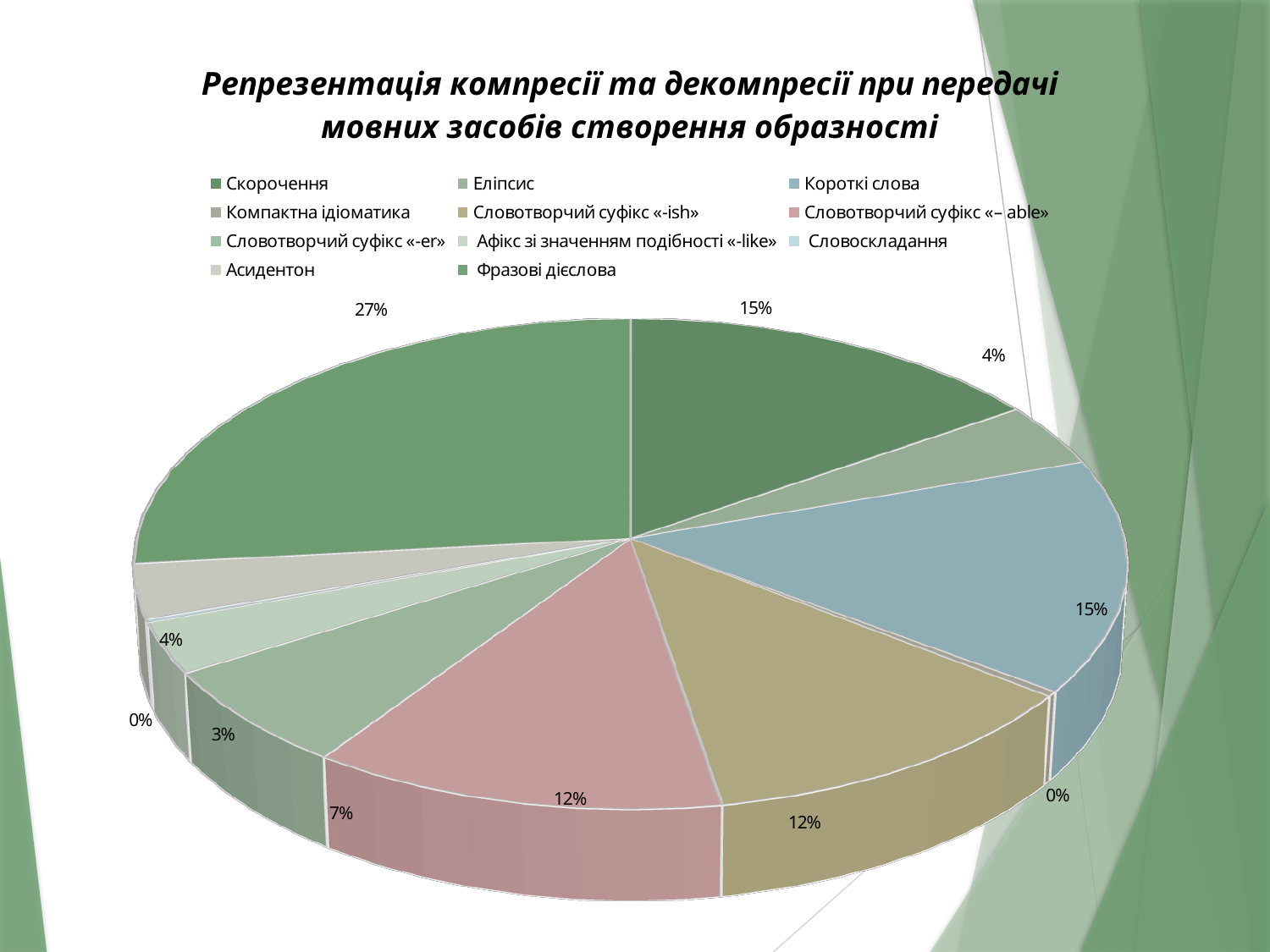
How many slices are labelled 0%? 2 What kind of chart is shown on the slide? pie chart Which is larger, the share for Скорочення or the share for Еліпсис? Скорочення Which category has the largest share of the pie? Фразові дієслова How many entries does the legend list? 11 What share of the pie does Словотворчий суфікс «-ish» have? 12% What is the title of the chart? Репрезентація компресії та декомпресії при передачі мовних засобів створення образності What share of the pie does Афікс зі значенням подібності «-like» have? 3% What share of the pie does Словотворчий суфікс «-er» have? 7% What is the difference between the share for Фразові дієслова and the share for Словотворчий суфікс «– able»? 15%